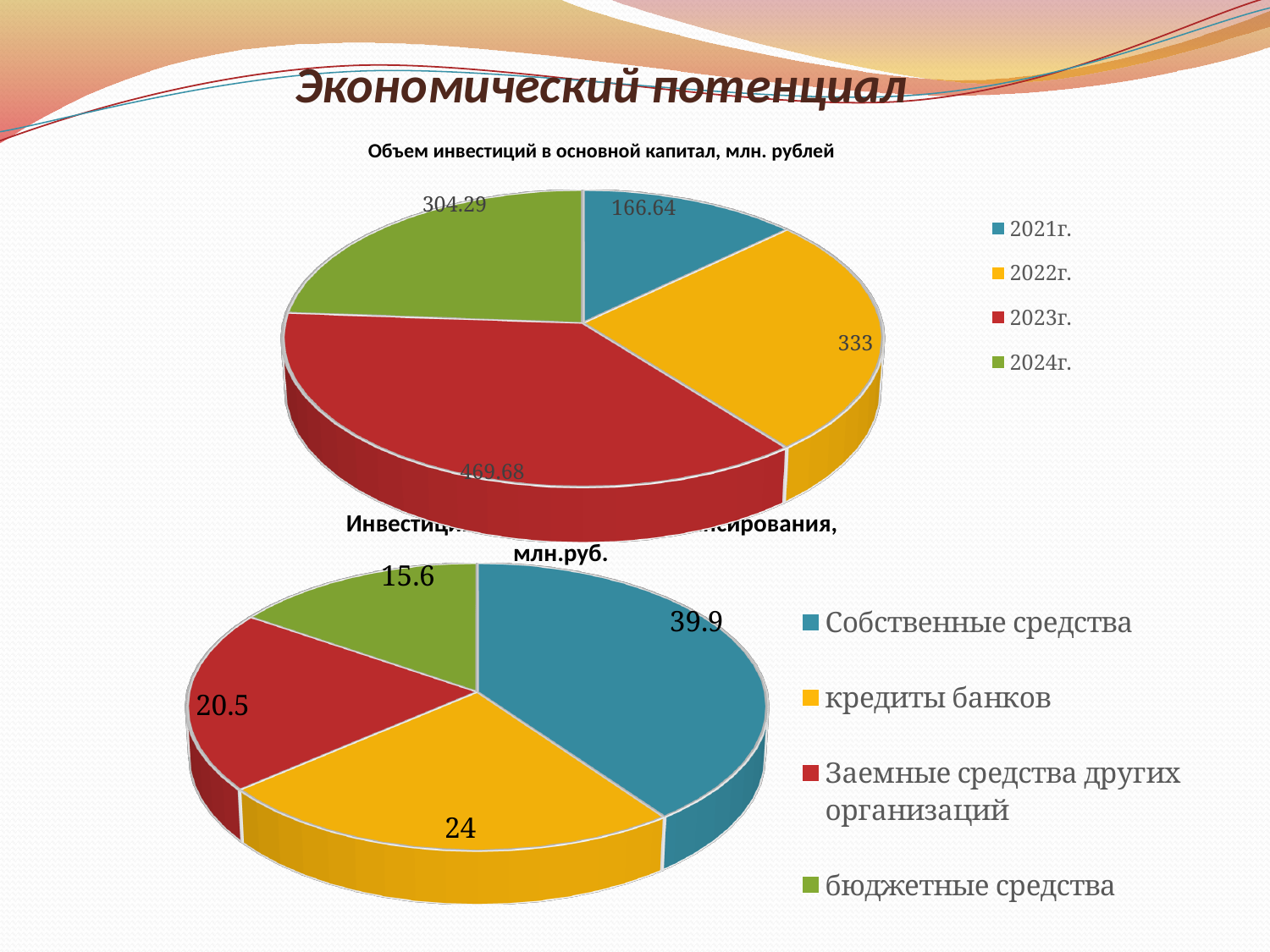
In the bottom pie chart, what colour is the slice for 'Заемные средства других организаций'? Red In the top chart 'Объем инвестиций в основной капитал, млн. рублей', which is larger: the value for 2022г. or for 2024г.? 2022г. In the top chart 'Объем инвестиций в основной капитал, млн. рублей', which year has the largest value? 2023г. How many years does the legend of the top chart list? 4 In the top chart 'Объем инвестиций в основной капитал, млн. рублей', which year has the smallest value? 2021г. In the top chart 'Объем инвестиций в основной капитал, млн. рублей', what is the value for 2021г.? 166.64 In the bottom pie chart, which category has the largest value? Собственные средства In the bottom pie chart, what is the difference between the values for 'Собственные средства' and 'бюджетные средства'? 24.3 In the top chart 'Объем инвестиций в основной капитал, млн. рублей', what is the difference between the values for 2023г. and 2021г.? 303.04 What kind of chart is the bottom chart on the slide? Pie chart In the top chart 'Объем инвестиций в основной капитал, млн. рублей', what is the value for 2023г.? 469.68 In the bottom pie chart, what is the value for 'кредиты банков'? 24